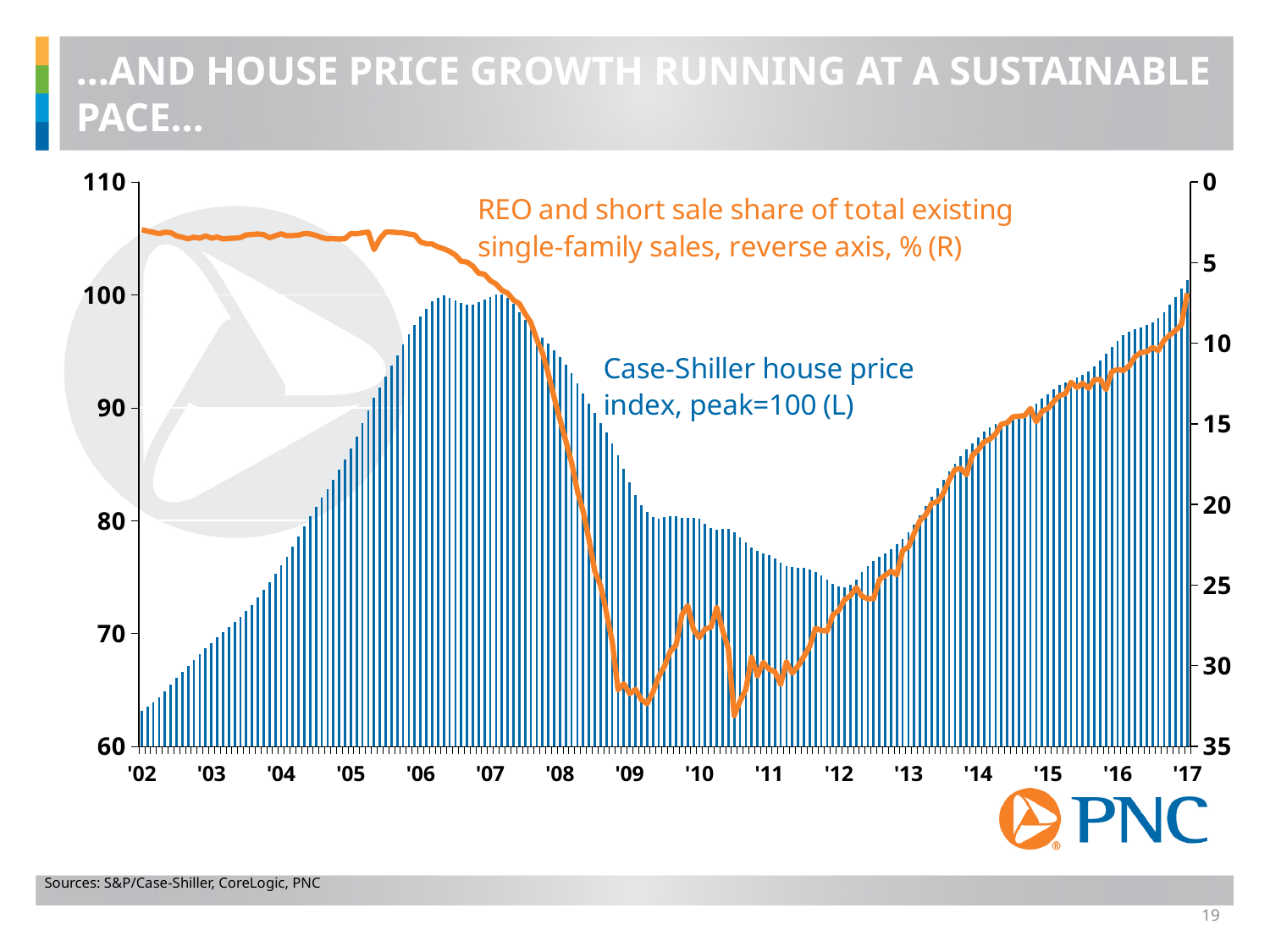
Is the REO and short sale share of sales in '09 greater or less than 25%? greater Is the Case-Shiller house price index at the start of '02 greater or less than 70? less What kind of chart is shown on the slide? bar and line chart Is the REO and short sale share of sales in '02 greater or less than 5%? less On which axis, left or right, is the Case-Shiller house price index plotted? left Does the Case-Shiller house price index rise or fall from '02 to '06? rises Does the Case-Shiller house price index rise or fall from '07 to '12? falls What is the title of the slide? ...AND HOUSE PRICE GROWTH RUNNING AT A SUSTAINABLE PACE... How many data series are plotted on the chart? 2 Which is larger, the Case-Shiller house price index in '06 or in '12? '06 How many year labels appear on the x axis? 16